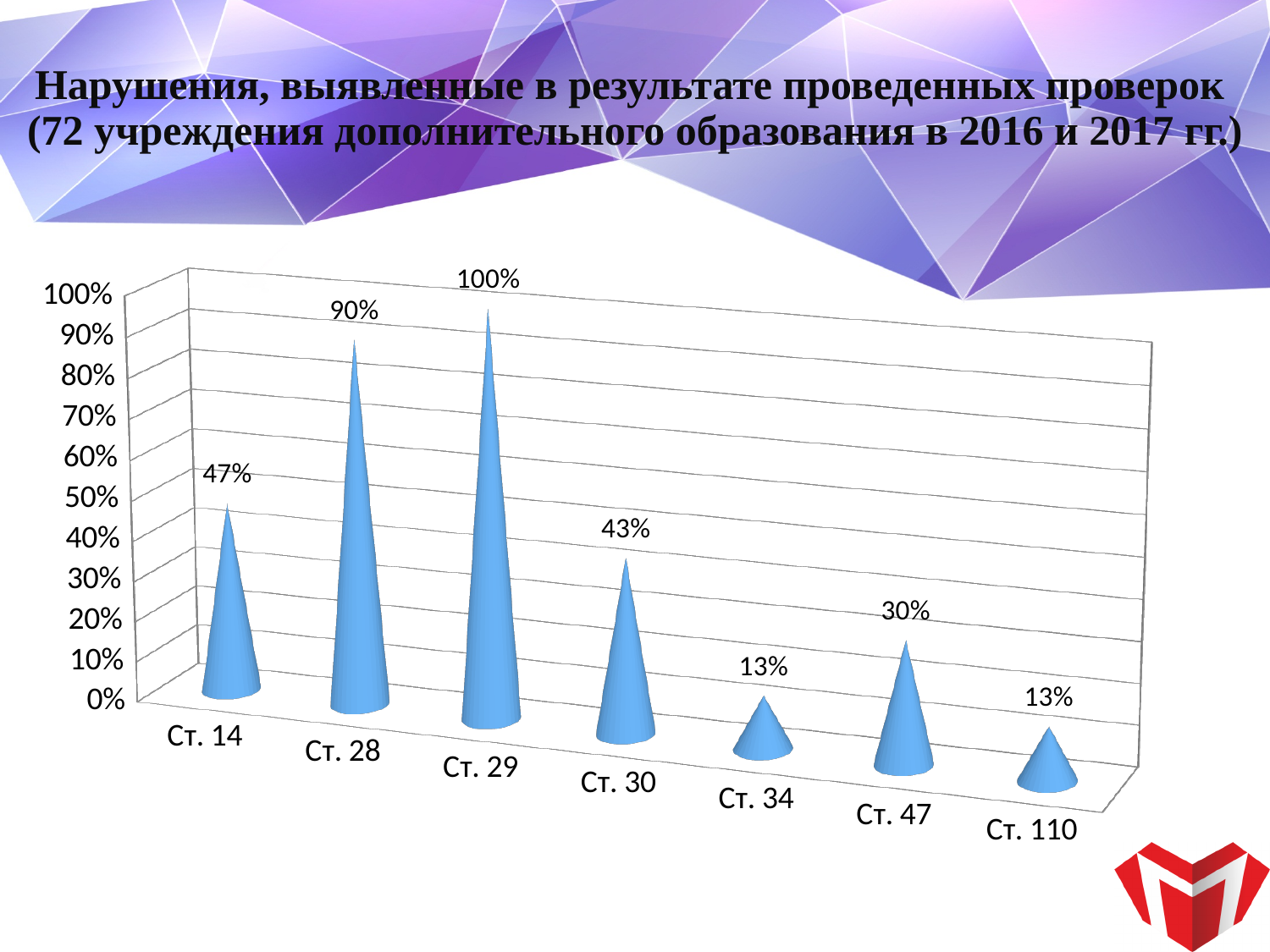
Which is larger, the value for Ст. 14 or the value for Ст. 47? Ст. 14 What kind of chart is shown on the slide? bar chart What is the value for Ст. 14? 47% What is the difference between the values for Ст. 28 and Ст. 30? 47% Which is larger, the value for Ст. 30 or the value for Ст. 28? Ст. 28 What is the value for Ст. 29? 100% Which category has the highest value? Ст. 29 What is the value for Ст. 47? 30% What is the value for Ст. 34? 13% What is the highest value shown on the vertical axis? 100% What is the difference between the values for Ст. 29 and Ст. 110? 87% How many categories are shown on the x axis? 7